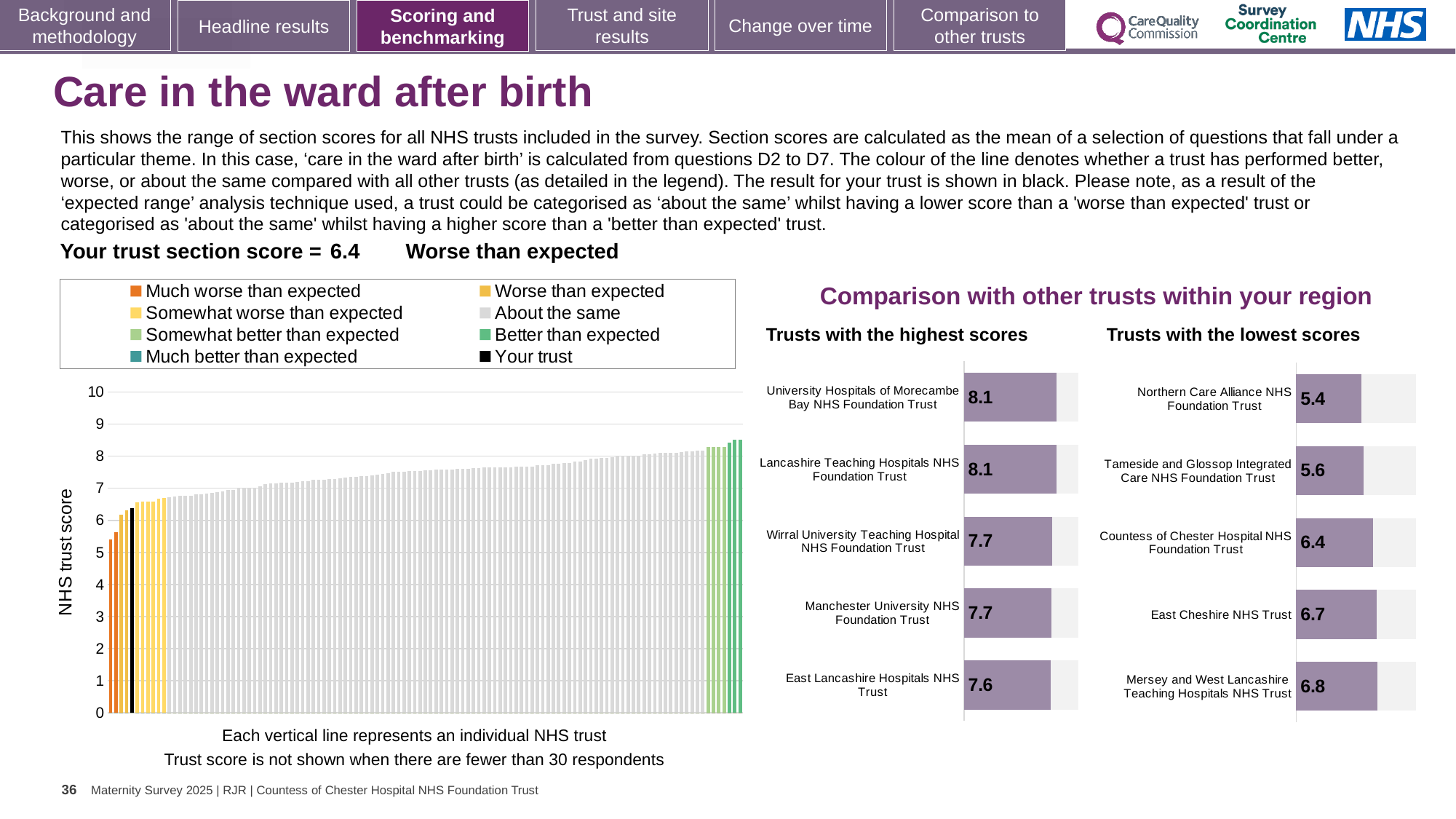
What kind of chart is the large 'NHS trust score' chart on the left of the slide? Bar chart In the 'Trusts with the lowest scores' chart, what is the score for Northern Care Alliance NHS Foundation Trust? 5.4 In the 'Trusts with the lowest scores' chart, which trust has the lowest score? Northern Care Alliance NHS Foundation Trust How many entries does the legend above the large 'NHS trust score' chart list? 8 In the large 'NHS trust score' chart on the left, do the bar values rise or fall from left to right? Rise What is the title of the section containing the two small bar charts on the right of the slide? Comparison with other trusts within your region In the 'Trusts with the lowest scores' chart, what is the score for Countess of Chester Hospital NHS Foundation Trust? 6.4 How many trusts are shown in the 'Trusts with the highest scores' chart? 5 In the 'Trusts with the highest scores' chart, what is the score for East Lancashire Hospitals NHS Trust? 7.6 In the large 'NHS trust score' chart on the left, is the value of the tallest bar greater or less than 8? greater In the 'Trusts with the highest scores' chart, which has the higher score: Wirral University Teaching Hospital NHS Foundation Trust or East Lancashire Hospitals NHS Trust? Wirral University Teaching Hospital NHS Foundation Trust In the 'Trusts with the lowest scores' chart, what is the difference between the scores of Mersey and West Lancashire Teaching Hospitals NHS Trust and Northern Care Alliance NHS Foundation Trust? 1.4